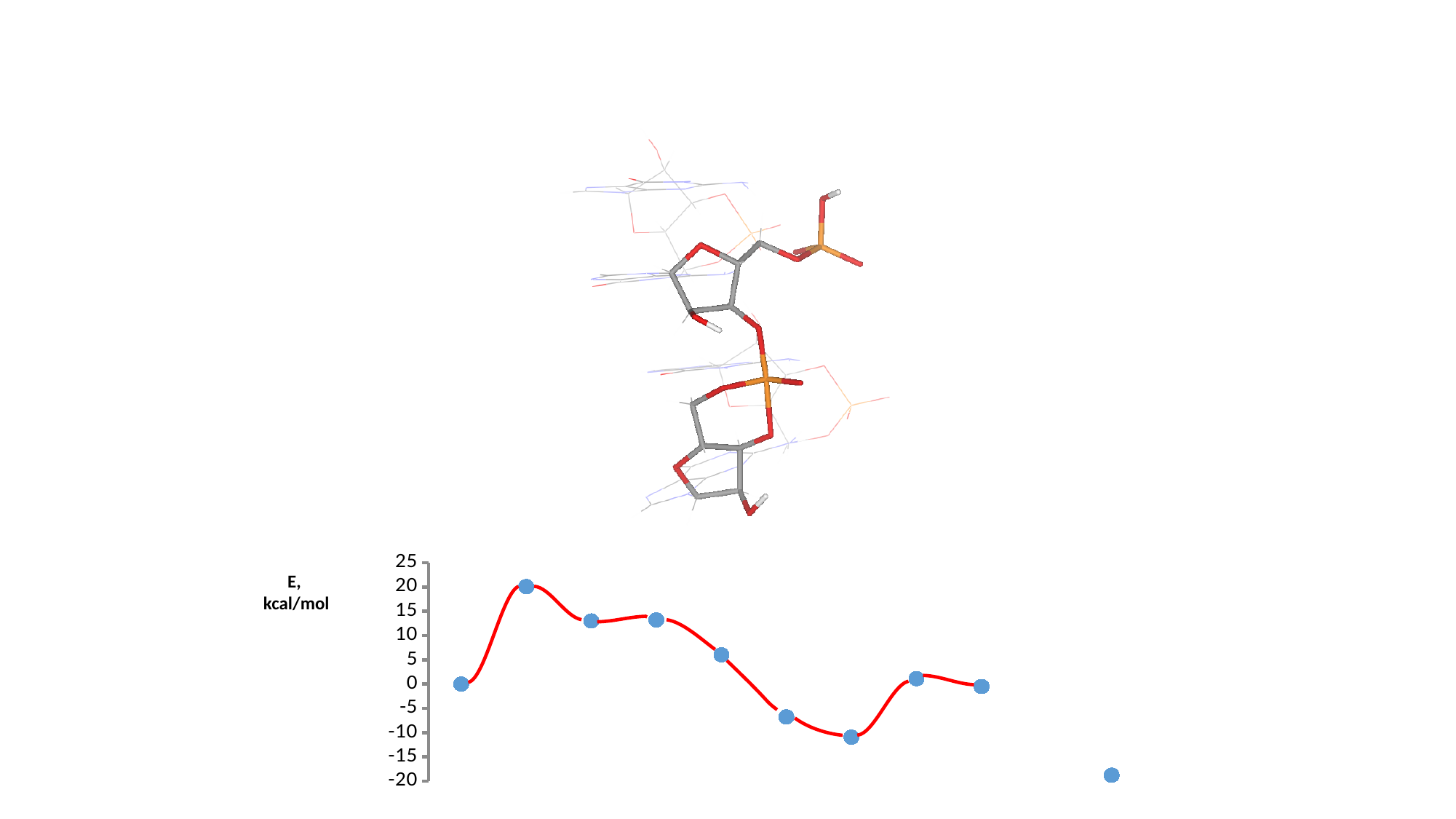
What is the label on the vertical axis of the chart? E, kcal/mol Is the value of the second point from the left greater or less than 15? greater What kind of chart is shown at the bottom of the slide? line chart What is the highest value shown on the vertical axis of the chart? 25 Is the value of the third point from the left greater or less than 10? greater Which point on the chart has the lowest value? the isolated point at the far right Which point on the chart has the highest value: the second point from the left or the fourth point from the left? the second point from the left How many data points are plotted on the chart? 10 Is the value of the sixth point from the left greater or less than 0? less Does the curve rise or fall between the first and second points from the left? rise